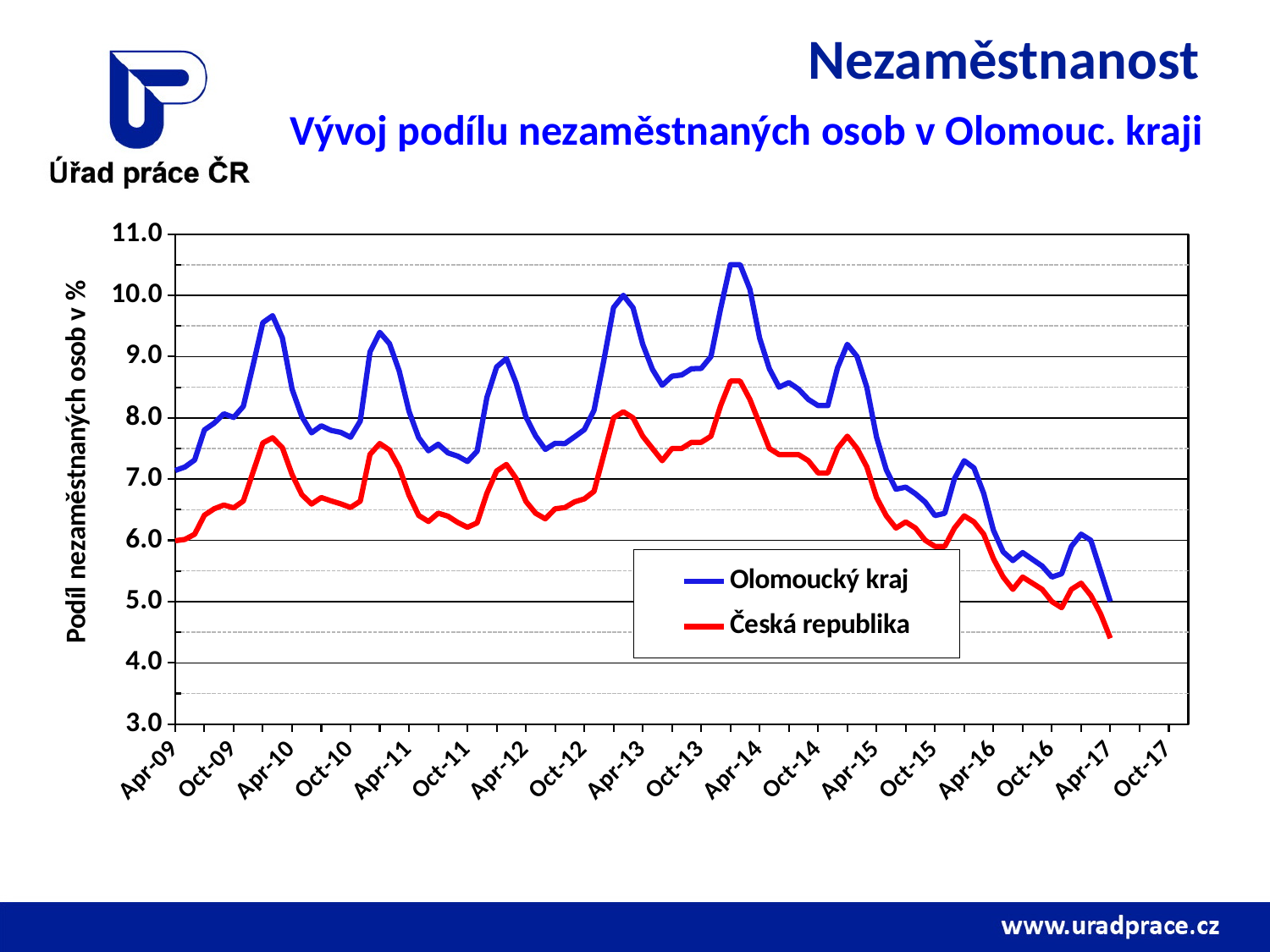
Is the value for Olomoucký kraj at Apr-14 greater or less than 10.0? less Which series has the higher value at Apr-14, Olomoucký kraj or Česká republika? Olomoucký kraj What is the title of the chart? Vývoj podílu nezaměstnaných osob v Olomouc. kraji What kind of chart is shown on the slide? line chart Is the value for Česká republika at Apr-17 greater or less than 5.0? less Which two series are listed in the legend? Olomoucký kraj and Česká republika How many labels are shown on the x axis? 18 Is the value for Olomoucký kraj at Apr-10 greater or less than 9.0? less Do the values for Olomoucký kraj rise or fall between Apr-14 and Apr-17? fall Around which x-axis label does the Olomoucký kraj series reach its highest value? Apr-14 How many series does the legend list? 2